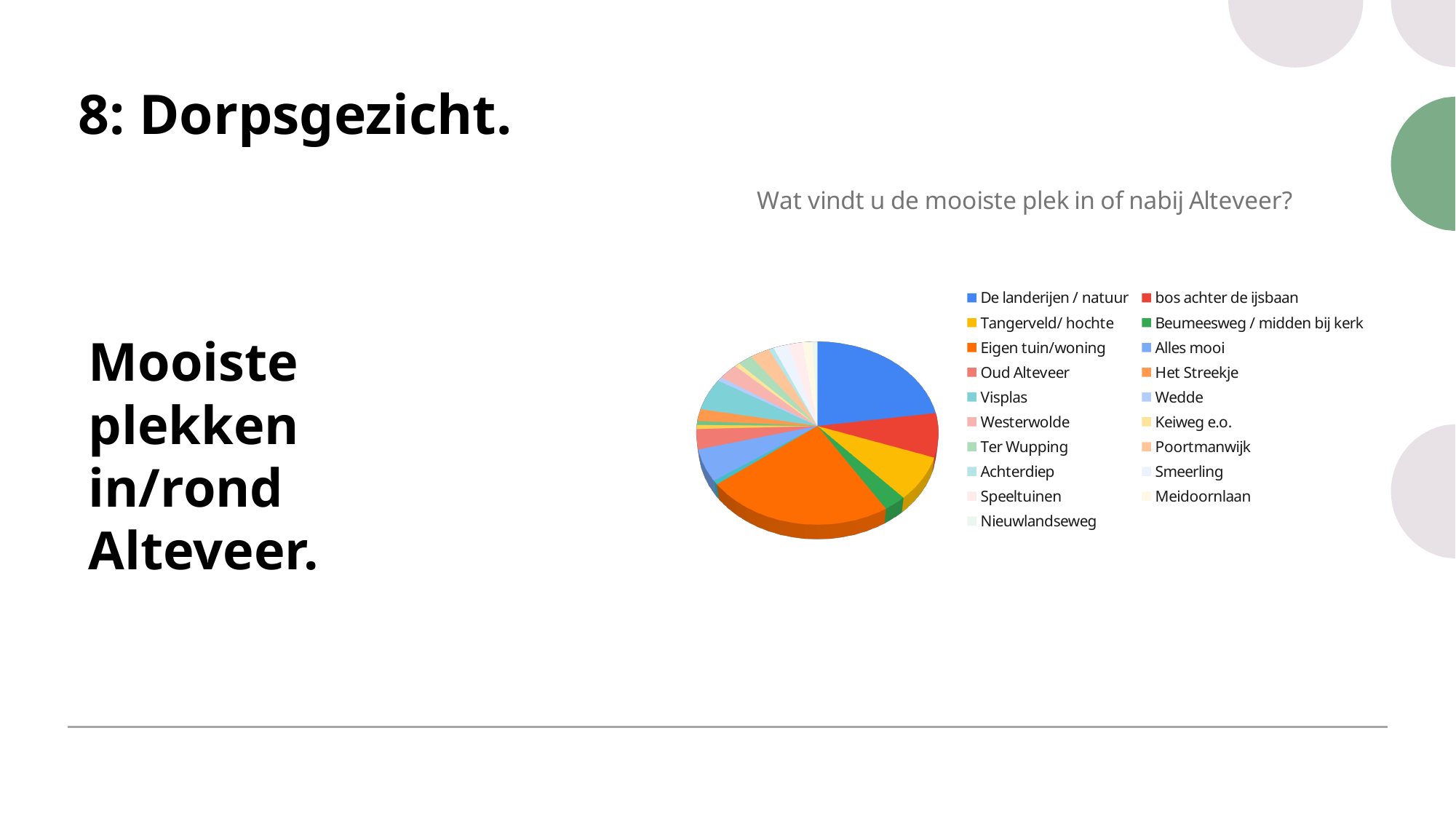
What kind of chart is shown on the slide? pie chart Which slice is larger, Eigen tuin/woning or bos achter de ijsbaan? Eigen tuin/woning Which slice is larger, De landerijen / natuur or Oud Alteveer? De landerijen / natuur What colour is the slice for De landerijen / natuur in the pie chart? blue Which slice is larger, De landerijen / natuur or Tangerveld/ hochte? De landerijen / natuur What is the title of the pie chart? Wat vindt u de mooiste plek in of nabij Alteveer? How many categories does the legend of the pie chart list? 19 Which category has the largest slice in the pie chart? Eigen tuin/woning